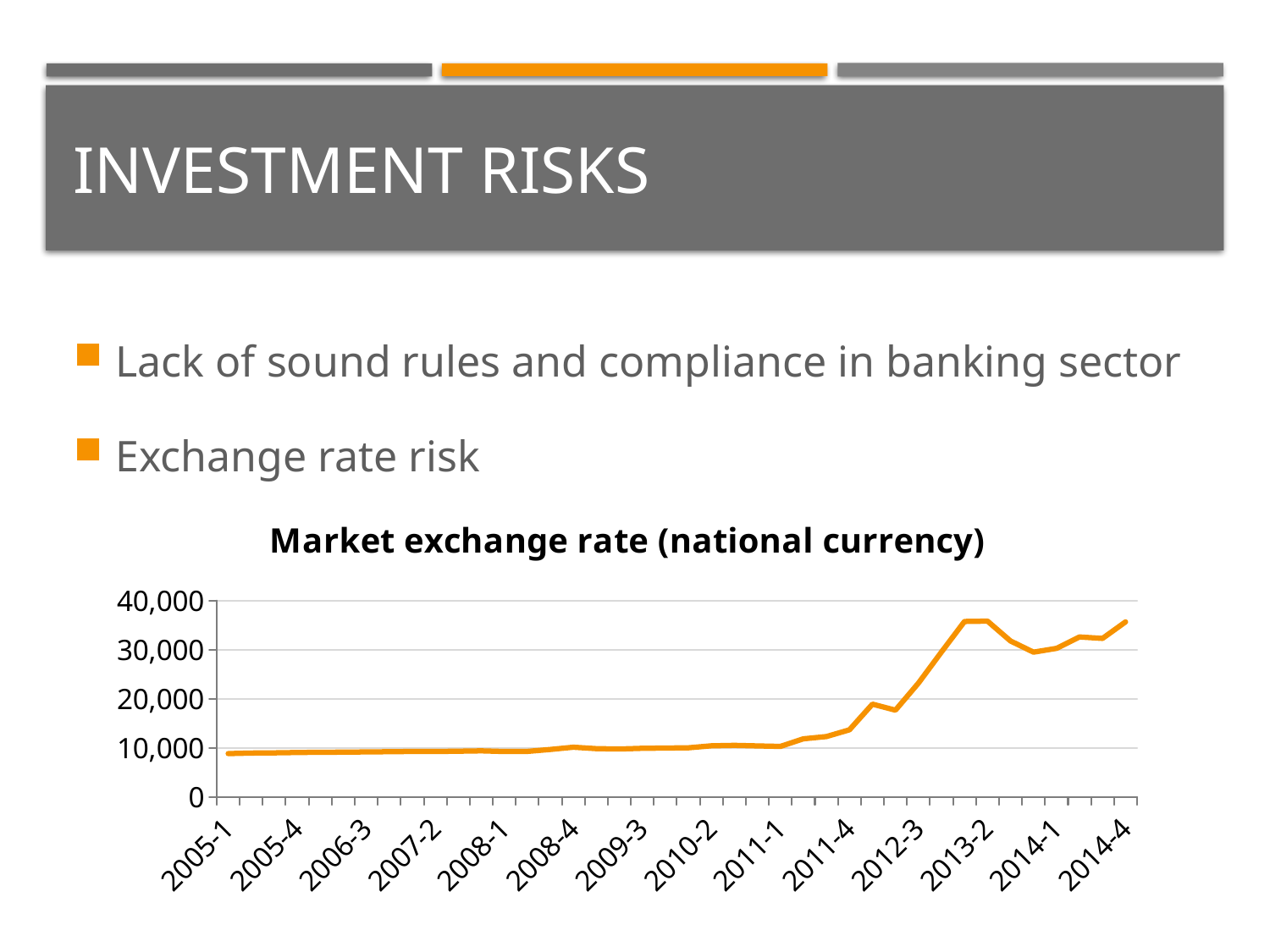
Is the value for 2013-2 greater or less than 30,000? greater What is the title of the chart? Market exchange rate (national currency) Which is larger, the value for 2013-2 or the value for 2011-1? 2013-2 What is the highest value shown on the vertical axis? 40,000 Do the values generally rise or fall from 2005-1 to 2014-4? rise Is the value for 2007-2 greater or less than 20,000? less Is the value for 2014-4 greater or less than 30,000? greater What kind of chart is shown on the slide? line chart Which is larger, the value for 2014-4 or the value for 2012-3? 2014-4